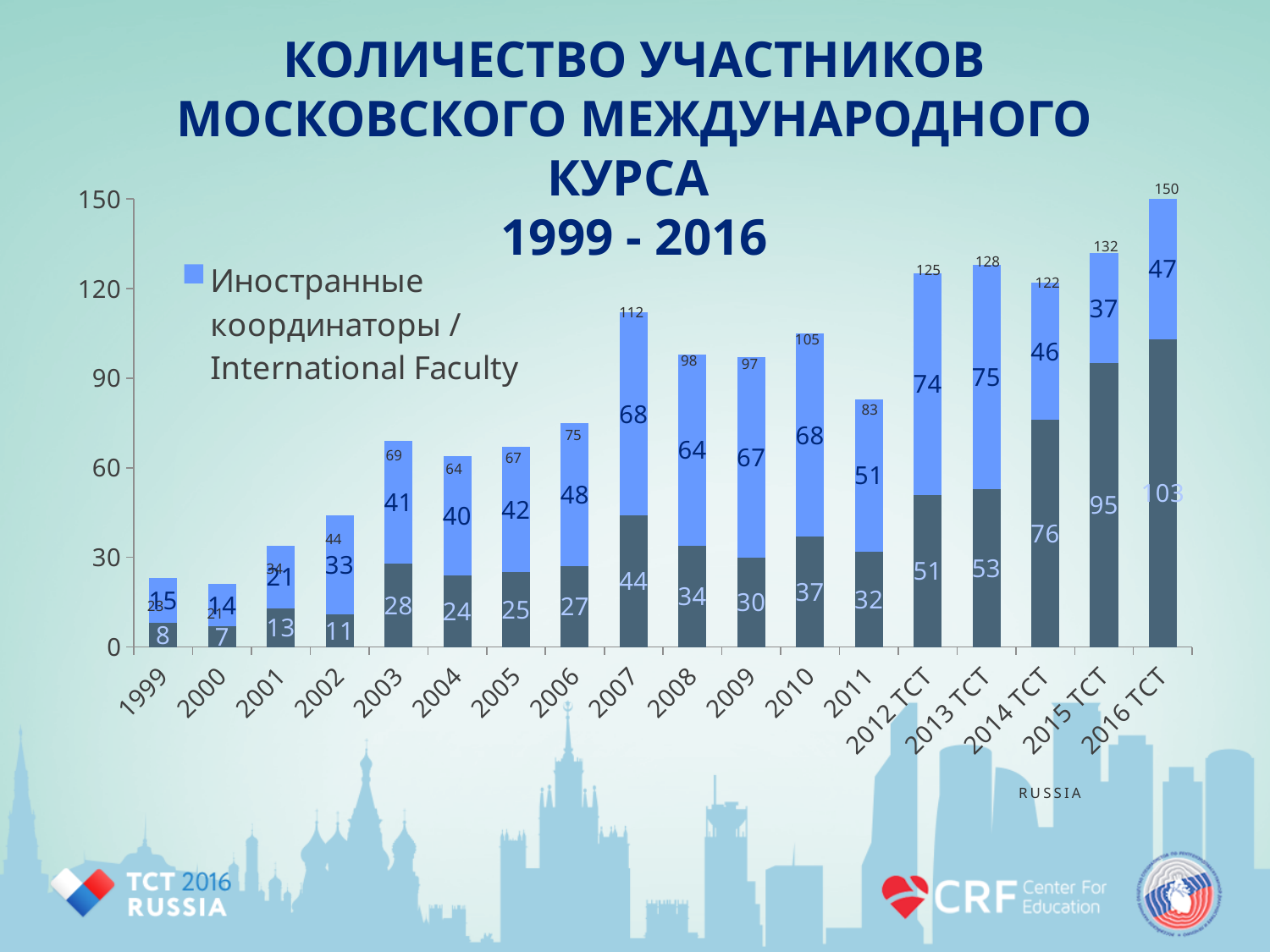
Is the total for 2010 greater or less than 90? greater What is the English name of the series shown in the legend? International Faculty Which year has the highest total number of participants? 2016 TCT What is the total number of participants shown for 2016 TCT? 150 Which has a larger total, 2011 or 2012 TCT? 2012 TCT What is the International Faculty value for 2007? 68 What kind of chart is shown on the slide? Stacked bar chart How many years (categories) are shown on the x axis? 18 What is the total of the stacked bar for 2003? 69 Which year has the lowest total number of participants? 2000 What is the difference between the International Faculty values for 2013 TCT and 2014 TCT? 29 What is the value of the dark blue (bottom) segment for 2015 TCT? 95